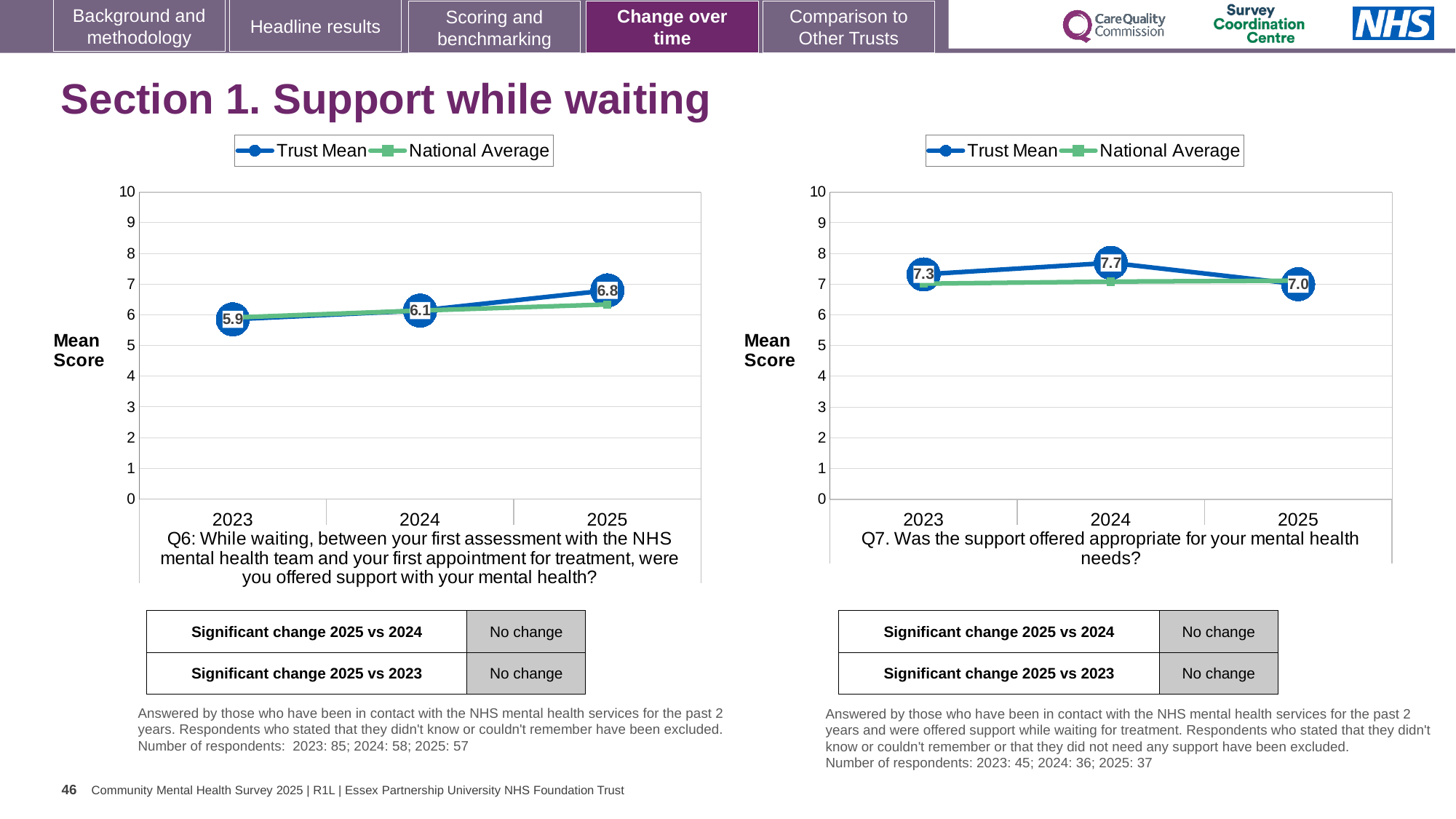
On the left chart (Q6), what is the Trust Mean score for 2023? 5.9 On the right chart (Q7), what is the Trust Mean score for 2024? 7.7 On the right chart (Q7), which year has the lowest Trust Mean score? 2025 How many series does the legend of the left chart (Q6) list? 2 On the left chart (Q6), does the Trust Mean score rise or fall from 2023 to 2025? rise What kind of chart is the right chart (Q7)? line chart On the left chart (Q6), which year has the highest Trust Mean score? 2025 On the left chart (Q6), what is the difference between the Trust Mean scores for 2025 and 2023? 0.9 On the right chart (Q7), what is the Trust Mean score for 2025? 7.0 On the right chart (Q7), is the Trust Mean score for 2023 greater or less than 7? greater On the right chart (Q7), what is the difference between the Trust Mean scores for 2024 and 2025? 0.7 On the left chart (Q6), what is the Trust Mean score for 2025? 6.8